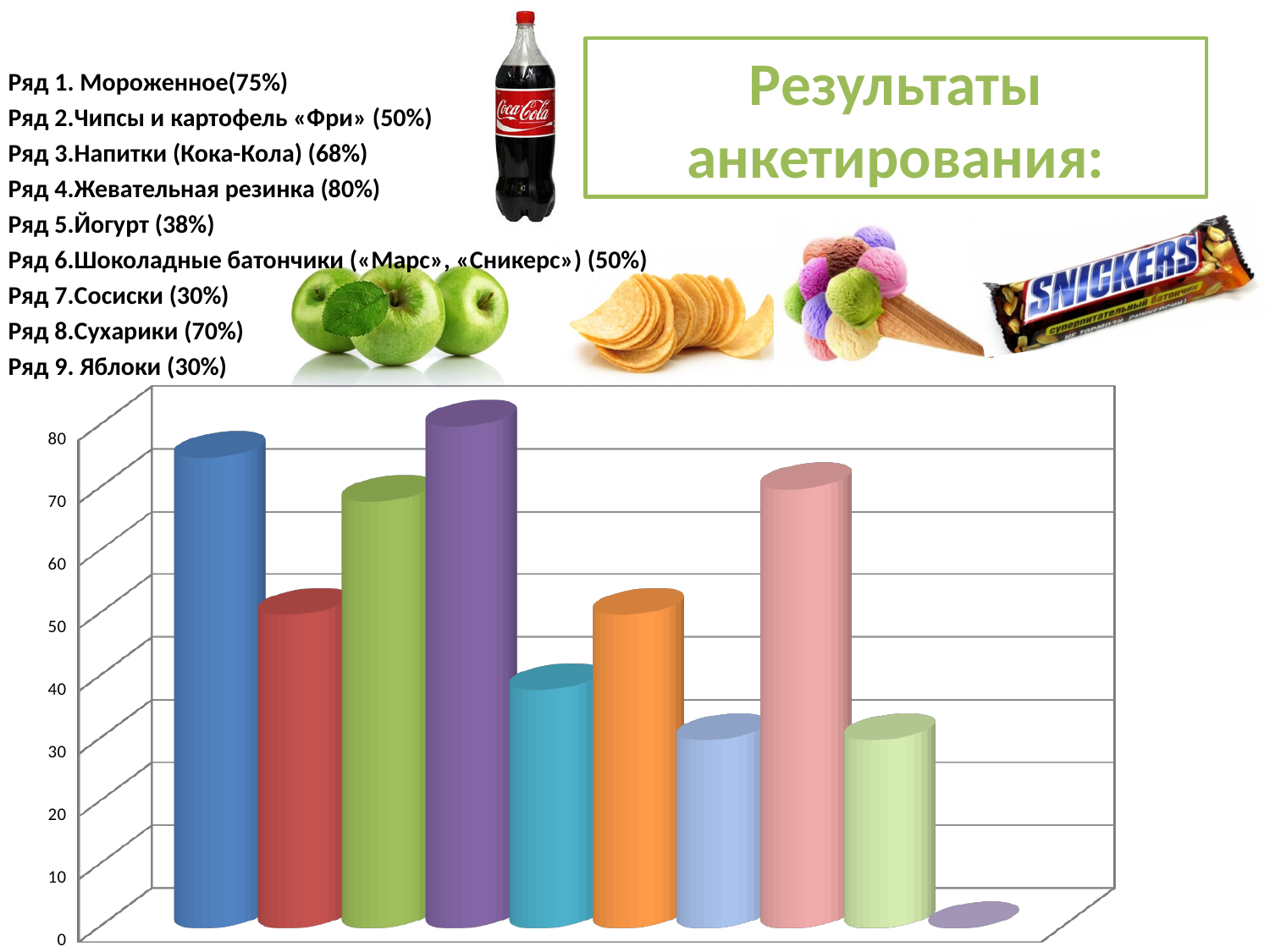
Is the bar for Ряд 3 (Напитки) greater or less than 60 on the axis? greater What kind of chart is shown on the slide? bar chart Is the bar for Ряд 7 (Сосиски) greater or less than 40 on the axis? less According to the list on the slide, what percentage is given for Ряд 8 (Сухарики)? 70% What is the difference between the percentages for Ряд 8 (Сухарики) and Ряд 9 (Яблоки)? 40% What is the title shown in the box at the top right of the slide? Результаты анкетирования: According to the list on the slide, what percentage is given for Ряд 4 (Жевательная резинка)? 80% What is the difference between the percentages for Ряд 4 (Жевательная резинка) and Ряд 5 (Йогурт)? 42% Which series has the tallest bar in the chart? Ряд 4 (Жевательная резинка) According to the list on the slide, what percentage is given for Ряд 5 (Йогурт)? 38% Which is larger, the value for Ряд 1 (Мороженное) or Ряд 2 (Чипсы и картофель «Фри»)? Ряд 1 (Мороженное) Is the bar for Ряд 2 (Чипсы и картофель «Фри») greater or less than 60 on the axis? less